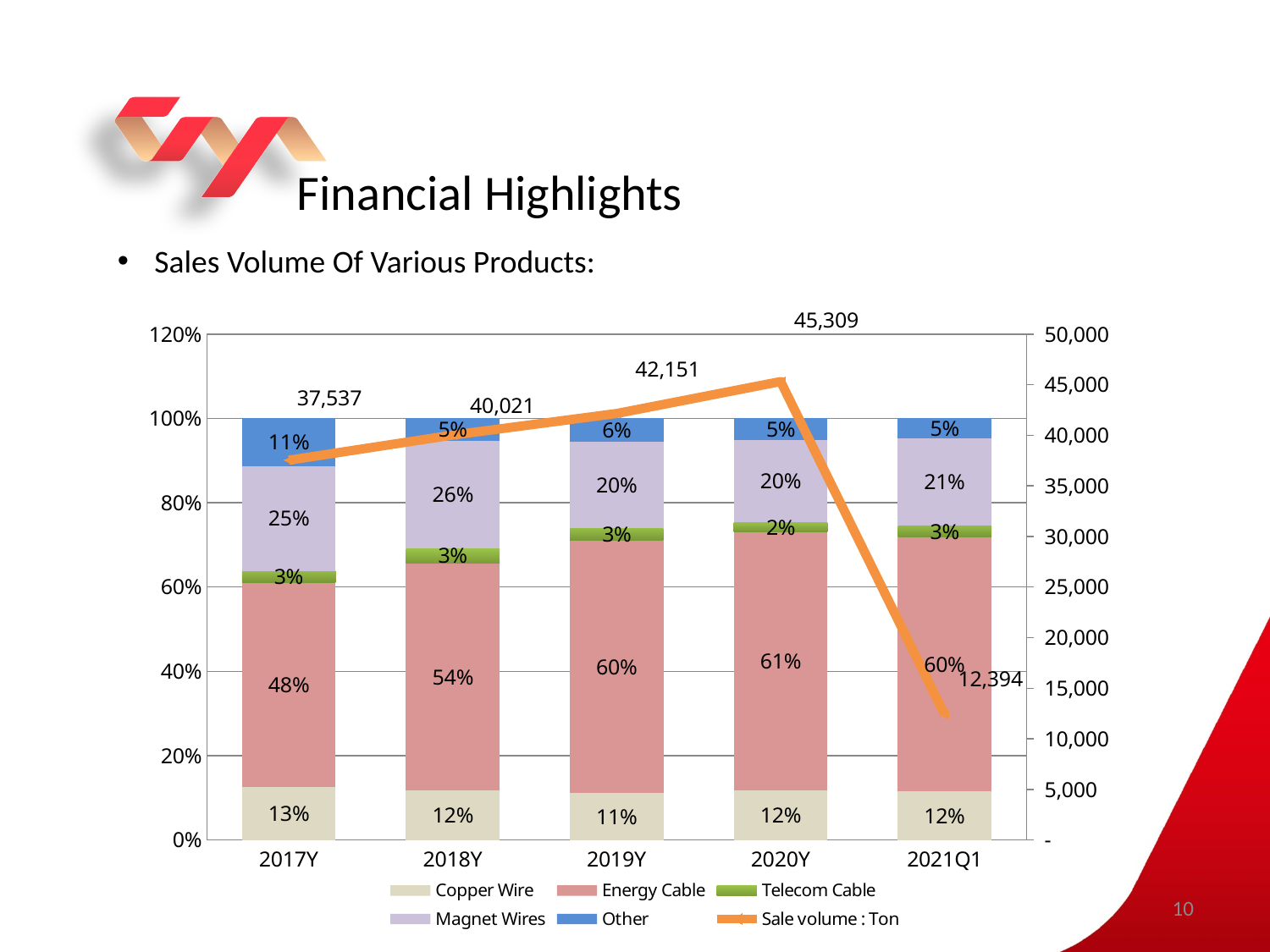
What percentage share does Magnet Wires have in 2021Q1? 21% What percentage share does Other have in 2017Y? 11% What is the sale volume in tons for 2020Y? 45,309 Which year has the highest sale volume in tons? 2020Y Which period has the lowest sale volume in tons? 2021Q1 How many series does the legend list? 6 What is the difference in sale volume between 2020Y and 2019Y? 3,158 Which series is plotted as a line rather than as stacked bars? Sale volume : Ton What percentage share does Energy Cable have in 2018Y? 54% Which is larger, the Energy Cable share in 2017Y or in 2020Y? 2020Y Did the sale volume in tons rise or fall from 2017Y to 2020Y? rise How many periods are shown on the x axis? 5